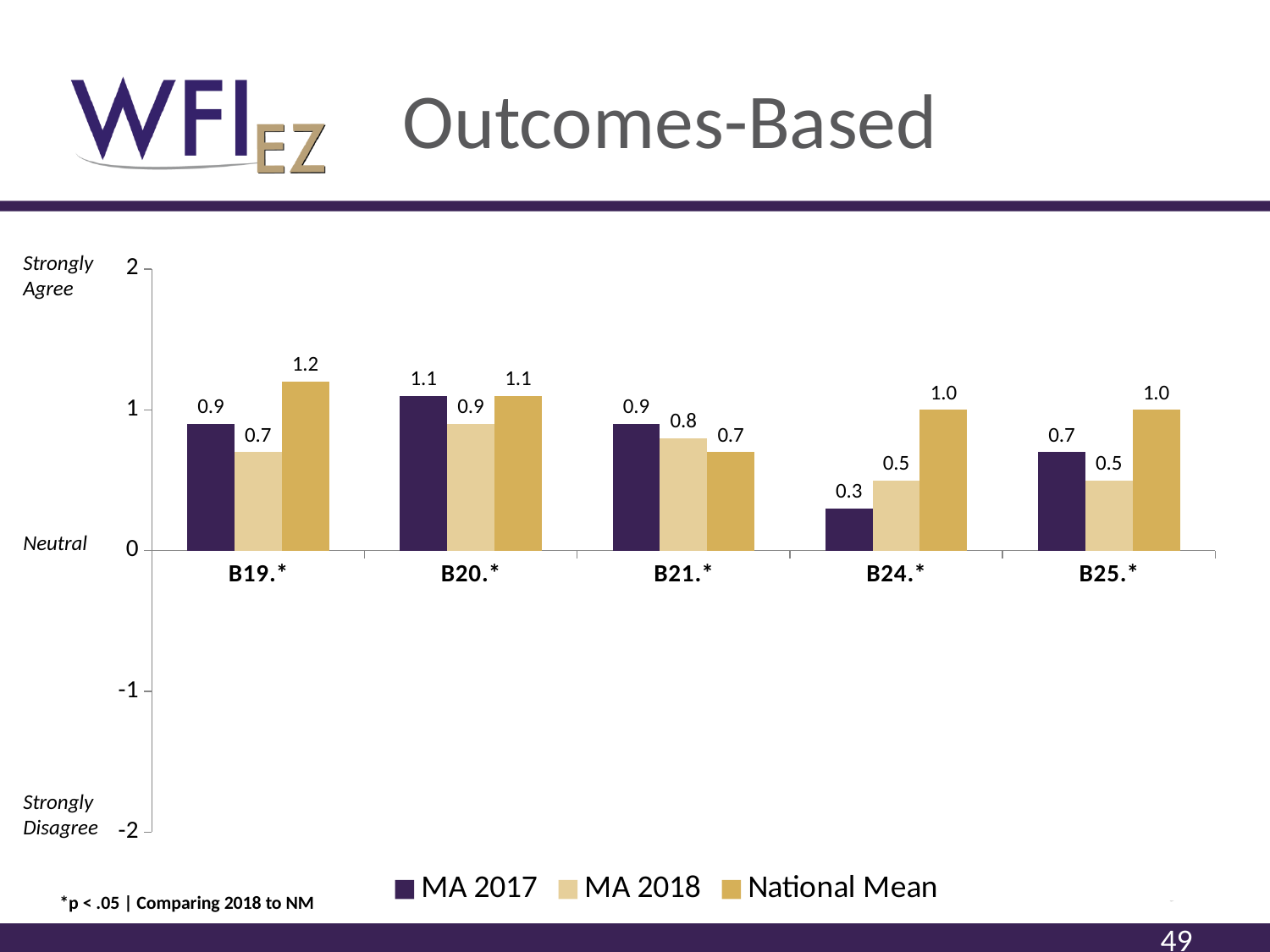
How many categories are shown on the x axis? 5 Which category has the lowest MA 2017 value? B24.* What is the difference between the National Mean and MA 2018 values for B19.*? 0.5 What kind of chart is shown on the slide? bar chart What is the MA 2018 value for B21.*? 0.8 Which category has the highest National Mean value? B19.* Is the MA 2017 value for B20.* greater or less than 1? greater What is the National Mean value for B24.*? 1.0 What is the title of the slide? Outcomes-Based What is the MA 2017 value for B19.*? 0.9 How many series does the legend list? 3 For B25.*, which is larger: the MA 2017 value or the National Mean value? National Mean